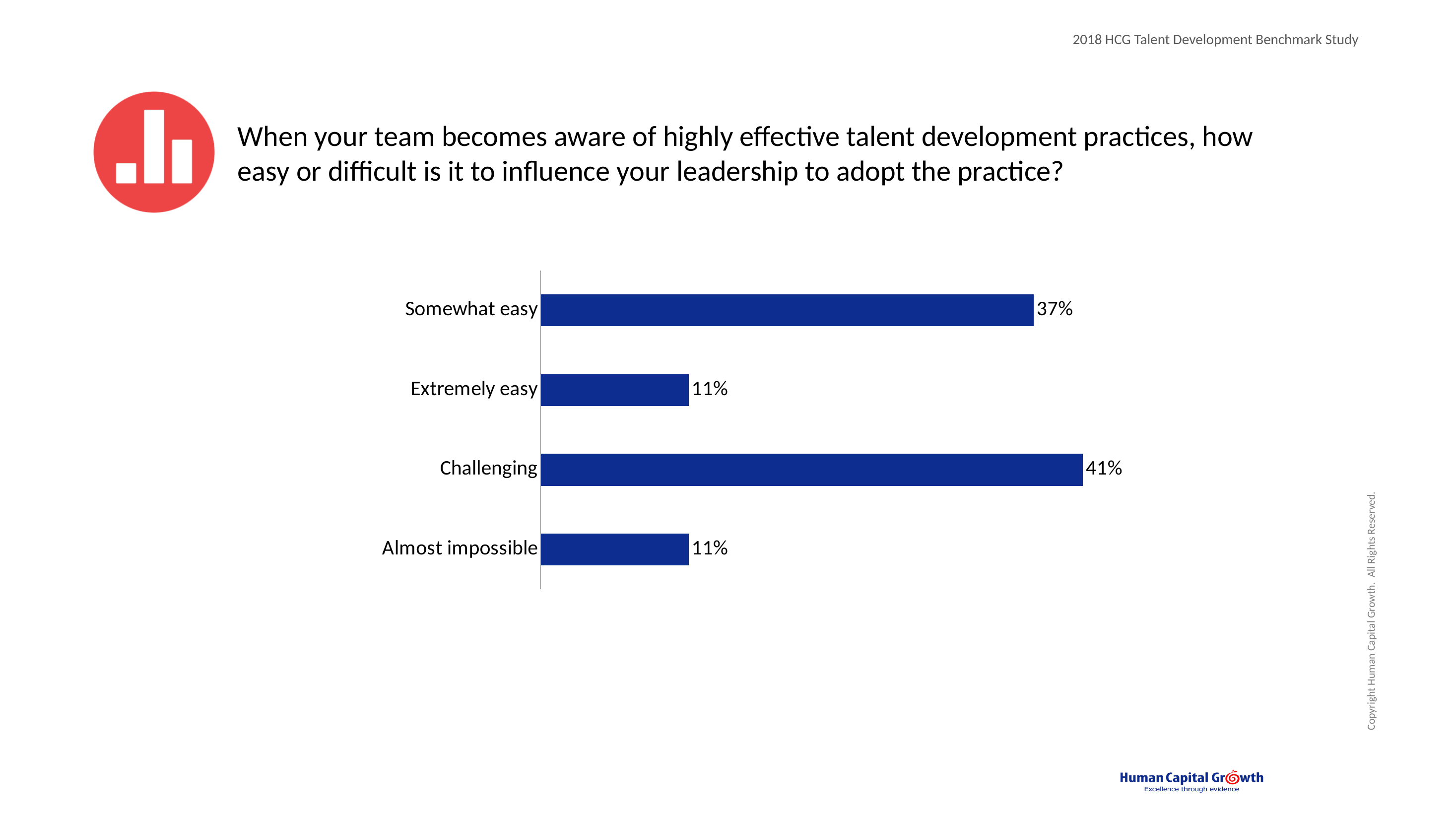
What colour are the bars in the chart? Dark blue What percentage of respondents said it is "Somewhat easy" to influence leadership to adopt the practice? 37% What is the combined value of "Somewhat easy" and "Extremely easy"? 48% Which category has the highest value? Challenging Which is larger, the value for "Challenging" or the value for "Somewhat easy"? Challenging What percentage is shown for "Extremely easy"? 11% What is the difference between the values for "Somewhat easy" and "Extremely easy"? 26% How many categories are shown in the chart? 4 What is the value shown for "Challenging"? 41% What is the difference between the values for "Challenging" and "Somewhat easy"? 4% What kind of chart is shown on the slide? Bar chart What is the value for "Almost impossible"? 11%